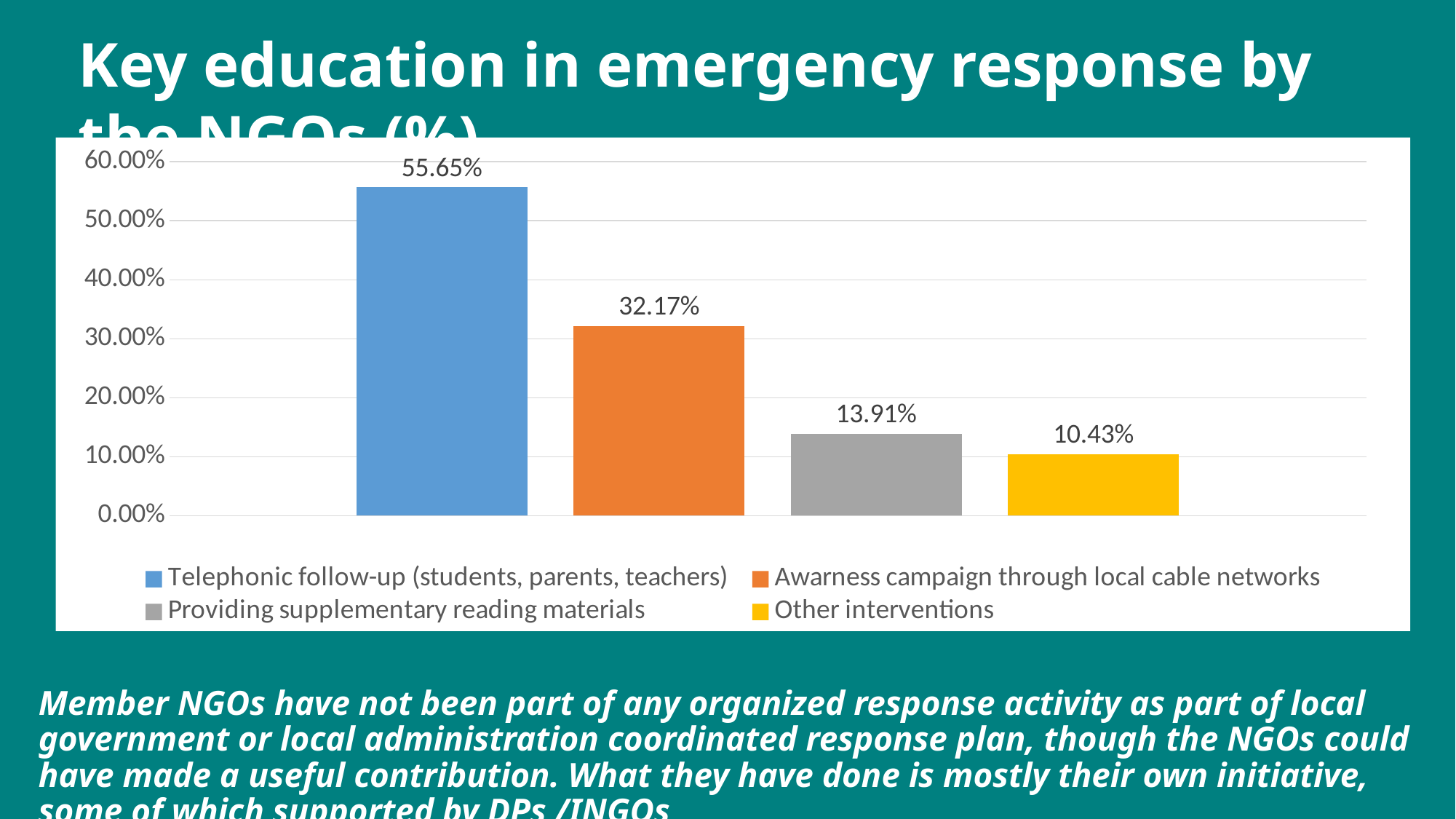
What percentage is shown for Other interventions? 10.43% What percentage is shown for Awarness campaign through local cable networks? 32.17% What percentage is shown for Providing supplementary reading materials? 13.91% Is the value for Awarness campaign through local cable networks greater or less than 30.00%? greater Which intervention has the lowest percentage? Other interventions What is the difference between the percentages for Telephonic follow-up and Awarness campaign through local cable networks? 23.48% How many bars are plotted in the chart? 4 Which intervention has the highest percentage? Telephonic follow-up (students, parents, teachers) Which is larger: Providing supplementary reading materials or Other interventions? Providing supplementary reading materials What type of chart is shown on the slide? Bar chart What percentage is shown for Telephonic follow-up (students, parents, teachers)? 55.65% How many entries does the legend list? 4